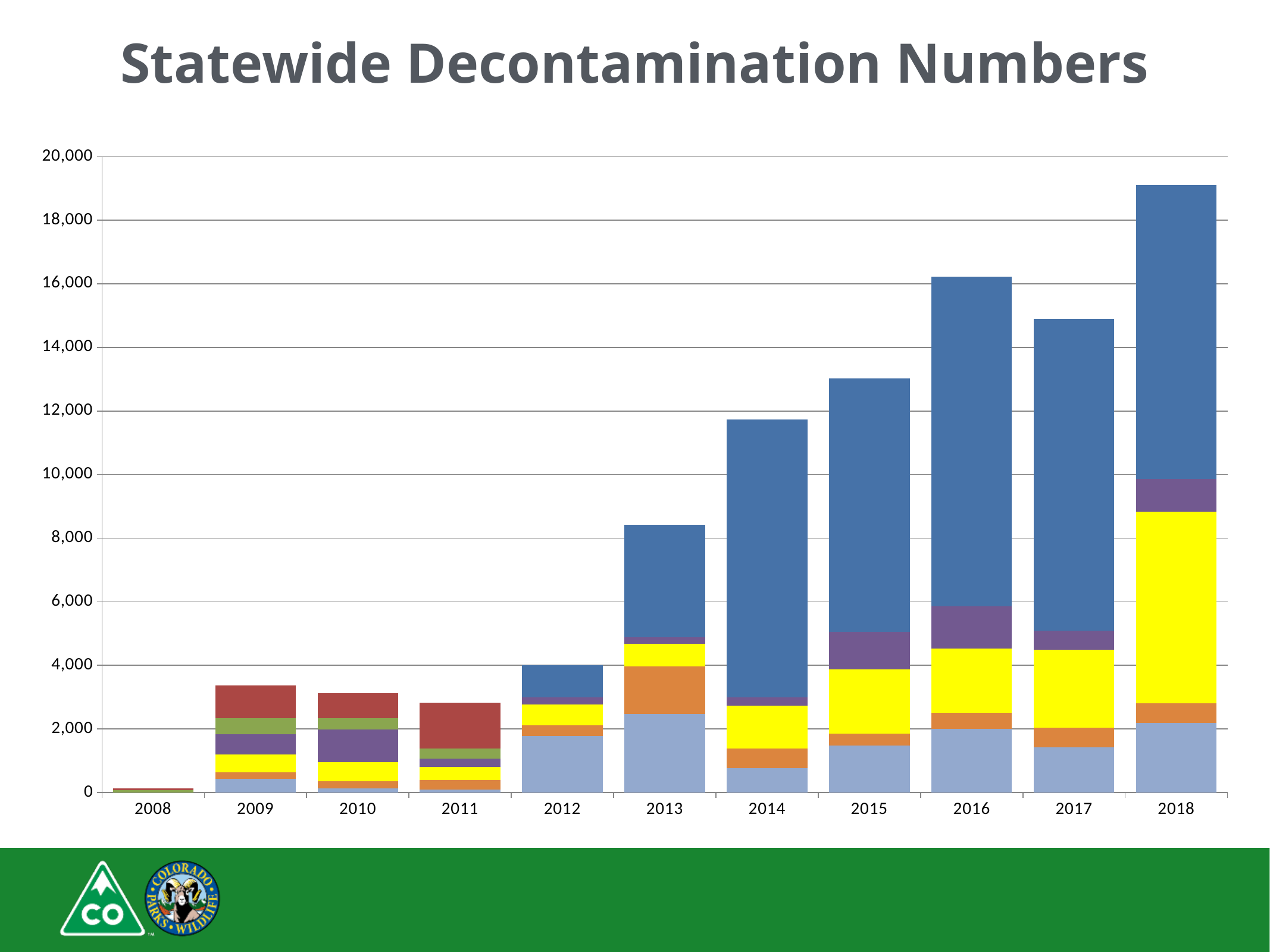
Which year has the larger total bar, 2016 or 2017? 2016 Is the total for 2014 greater or less than 12,000? less Is the total for 2009 greater or less than 4,000? less Which year has the larger total bar, 2014 or 2015? 2015 From 2012 to 2016, do the total bar heights rise or fall? rise What kind of chart is shown on the slide? Stacked bar chart Is the total for 2013 greater or less than 8,000? greater What is the title of the chart? Statewide Decontamination Numbers How many years are shown along the x axis? 11 Which year has the lowest total bar? 2008 Which year has the highest total bar? 2018